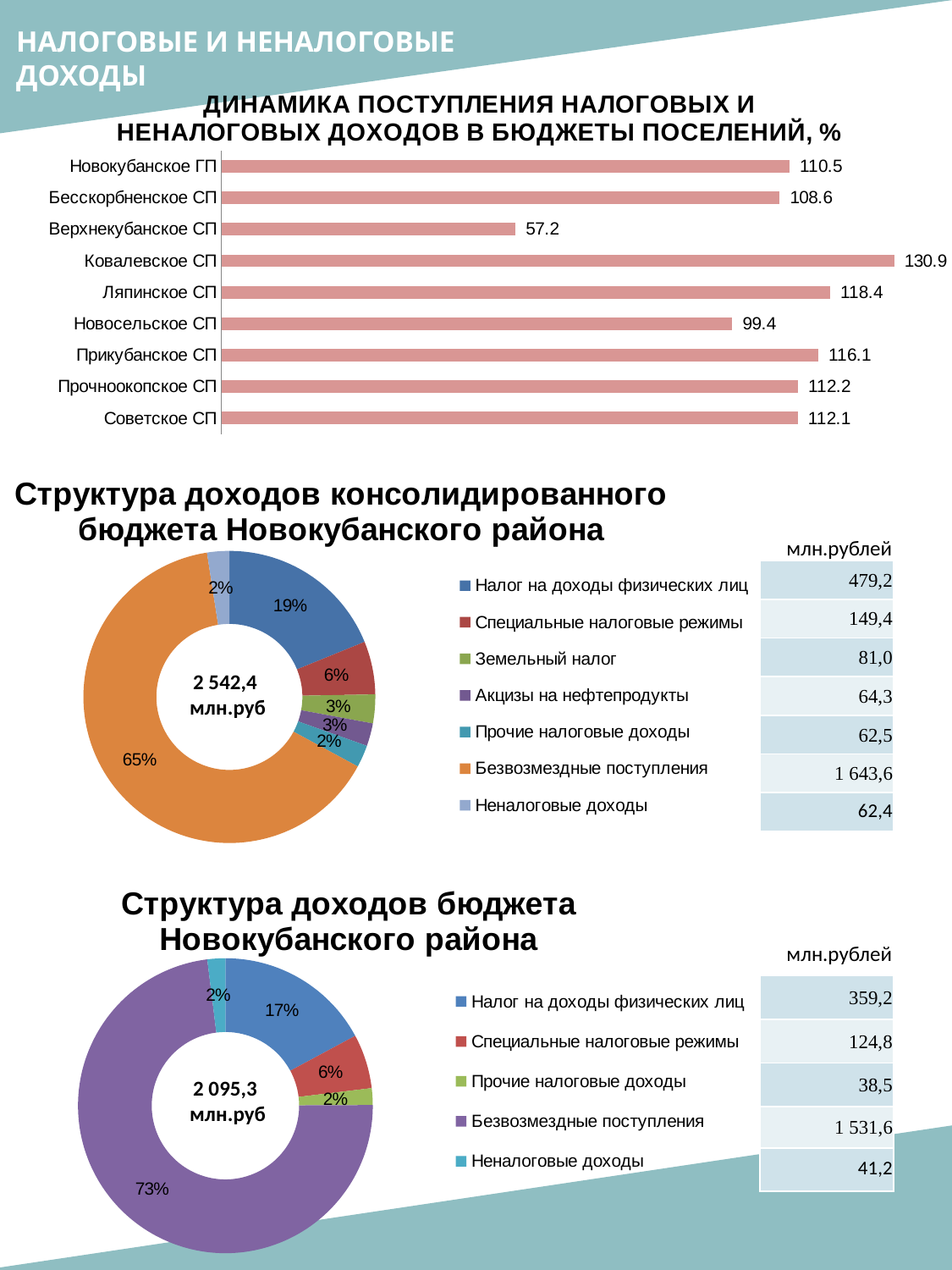
In the bar chart 'ДИНАМИКА ПОСТУПЛЕНИЯ НАЛОГОВЫХ И НЕНАЛОГОВЫХ ДОХОДОВ В БЮДЖЕТЫ ПОСЕЛЕНИЙ, %', what is the value for Ляпинское СП? 118.4 In the bar chart at the top of the slide, which is larger: the value for Новокубанское ГП or the value for Бесскорбненское СП? Новокубанское ГП What kind of chart is the chart at the top of the slide? Bar chart In the bar chart at the top of the slide, which settlement has the lowest value? Верхнекубанское СП In the chart 'Структура доходов консолидированного бюджета Новокубанского района', how many entries does the legend list? 7 How many settlements are shown in the bar chart at the top of the slide? 9 In the chart 'Структура доходов бюджета Новокубанского района', what share does Налог на доходы физических лиц have? 17% What total value is shown in the centre of the doughnut chart 'Структура доходов бюджета Новокубанского района'? 2 095,3 млн.руб In the bar chart at the top of the slide, what is the difference between the values for Ковалевское СП and Верхнекубанское СП? 73.7 In the chart 'Структура доходов бюджета Новокубанского района', which category has the largest share? Безвозмездные поступления In the bar chart at the top of the slide, which settlement has the highest value? Ковалевское СП In the chart 'Структура доходов консолидированного бюджета Новокубанского района', what share does Безвозмездные поступления have? 65%